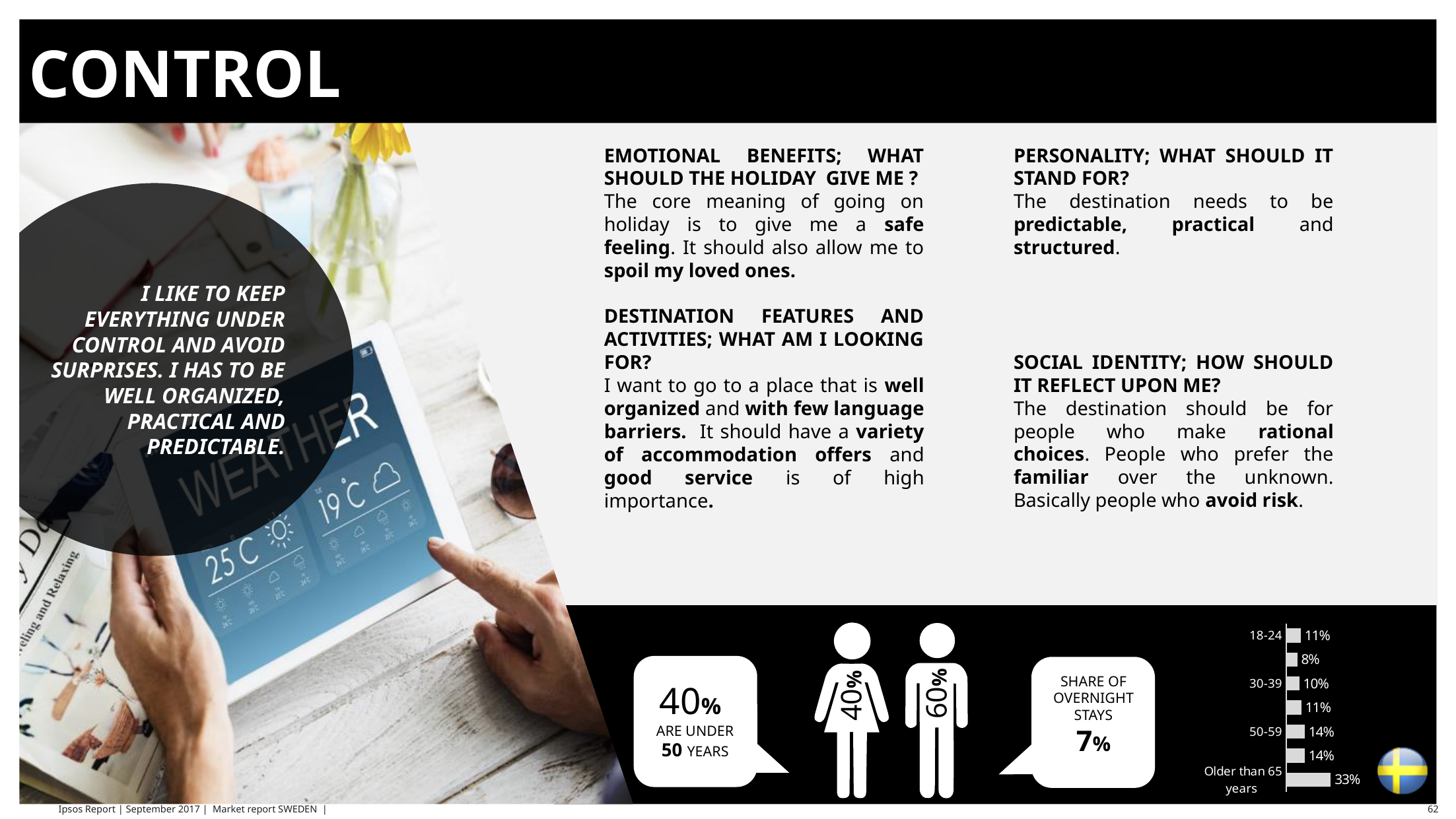
In the age-group bar chart, what is the difference between the value for 50-59 and the value for 30-39? 4 percentage points What kind of chart is shown at the bottom right of the slide? bar chart In the age-group bar chart, what is the value for 50-59? 14% In the age-group bar chart, what is the value for 30-39? 10% In the age-group bar chart, what colour are the bars? grey In the age-group bar chart, what is the difference between the value for Older than 65 years and the value for 18-24? 22 percentage points In the age-group bar chart, what is the value for 18-24? 11% In the age-group bar chart, which age group has the highest value? Older than 65 years In the age-group bar chart, what is the value for Older than 65 years? 33% In the age-group bar chart, which is larger: the value for Older than 65 years or the value for 30-39? Older than 65 years In the age-group bar chart, how many bars are plotted? 7 In the age-group bar chart, which is larger: the value for 50-59 or the value for 18-24? 50-59